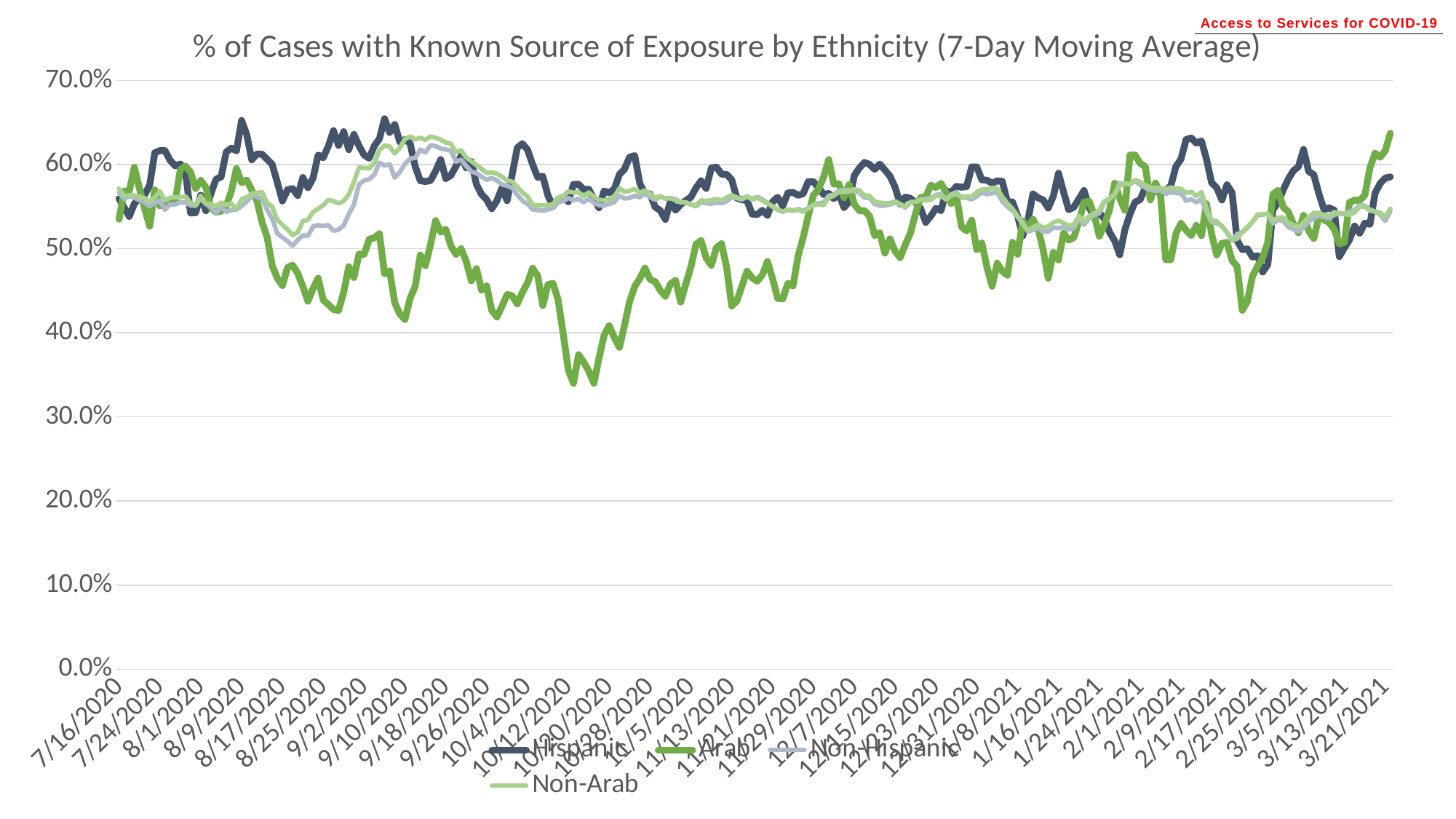
What is the title of the chart? % of Cases with Known Source of Exposure by Ethnicity (7-Day Moving Average) Around 9/2/2020, which series is higher, Hispanic or Arab? Hispanic What kind of chart is shown on the slide? line chart Which series drops to the lowest value anywhere on the chart? Arab Does the Arab line rise or fall between 10/20/2020 and 12/7/2020? rise How many series does the legend list? 4 What is the highest value shown on the vertical axis? 70.0% At 3/21/2021, which series is higher, Arab or Hispanic? Arab Is the Hispanic value around 9/10/2020 greater or less than 60%? greater Is the Non-Hispanic value around 8/25/2020 greater or less than 60%? less Is the Arab value at 3/21/2021 greater or less than 60%? greater